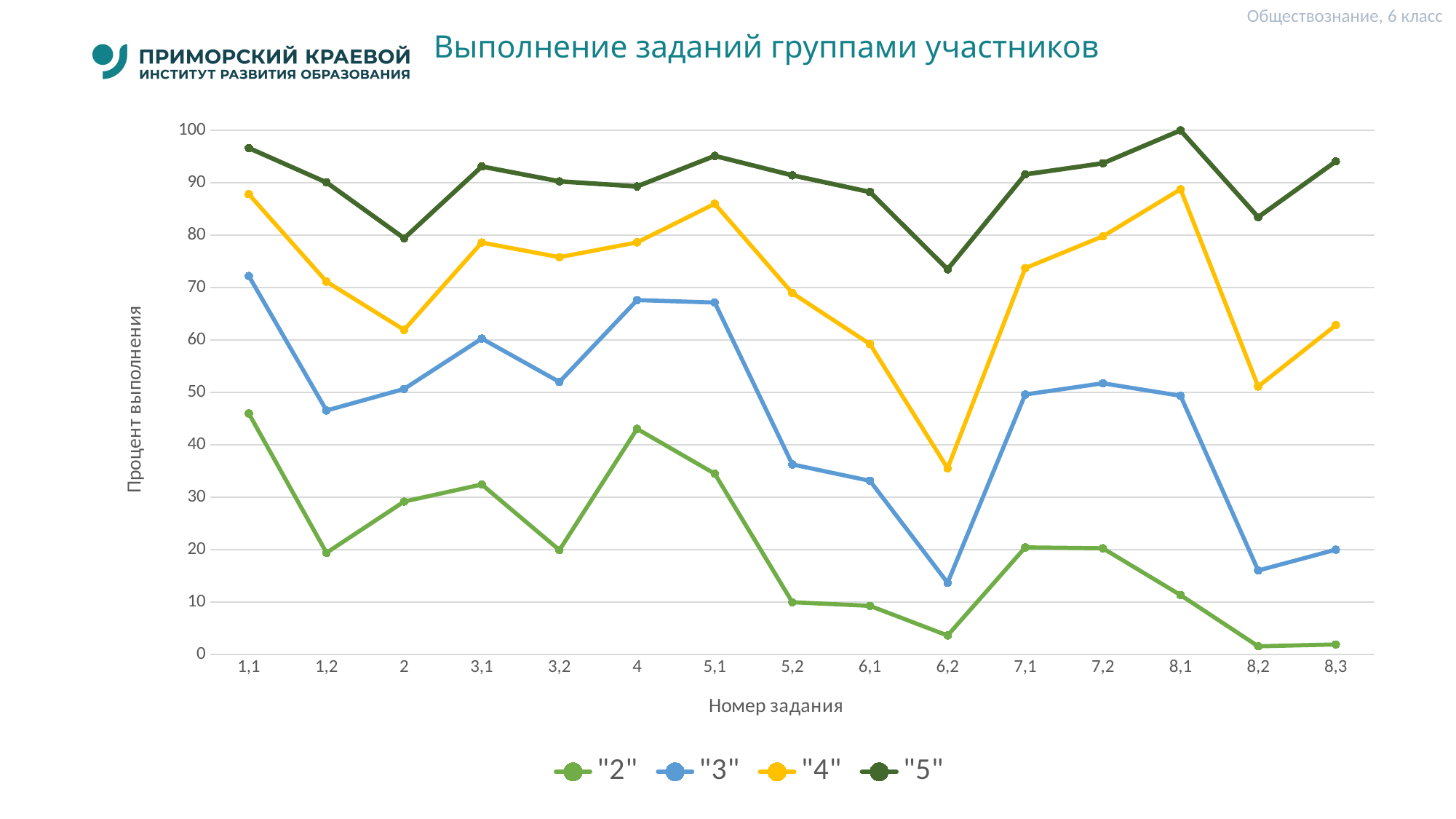
For which task number does the "4" series have its lowest value? 6,2 Is the value of the "4" series for task 6,2 greater or less than 40? less Which is larger for the "4" series: the value for task 8,1 or the value for task 8,2? 8,1 Does the "2" series rise or fall from task 5,1 to task 6,2? fall How many series does the legend list? 4 How many task numbers are plotted along the x axis? 15 What is the label of the vertical axis? Процент выполнения For which task number does the "3" series have its lowest value? 6,2 For which task number does the "5" series have its lowest value? 6,2 For which task number does the "5" series reach its highest value? 8,1 Is the value of the "2" series for task 1,1 greater or less than 40? greater What kind of chart is shown on the slide? line chart